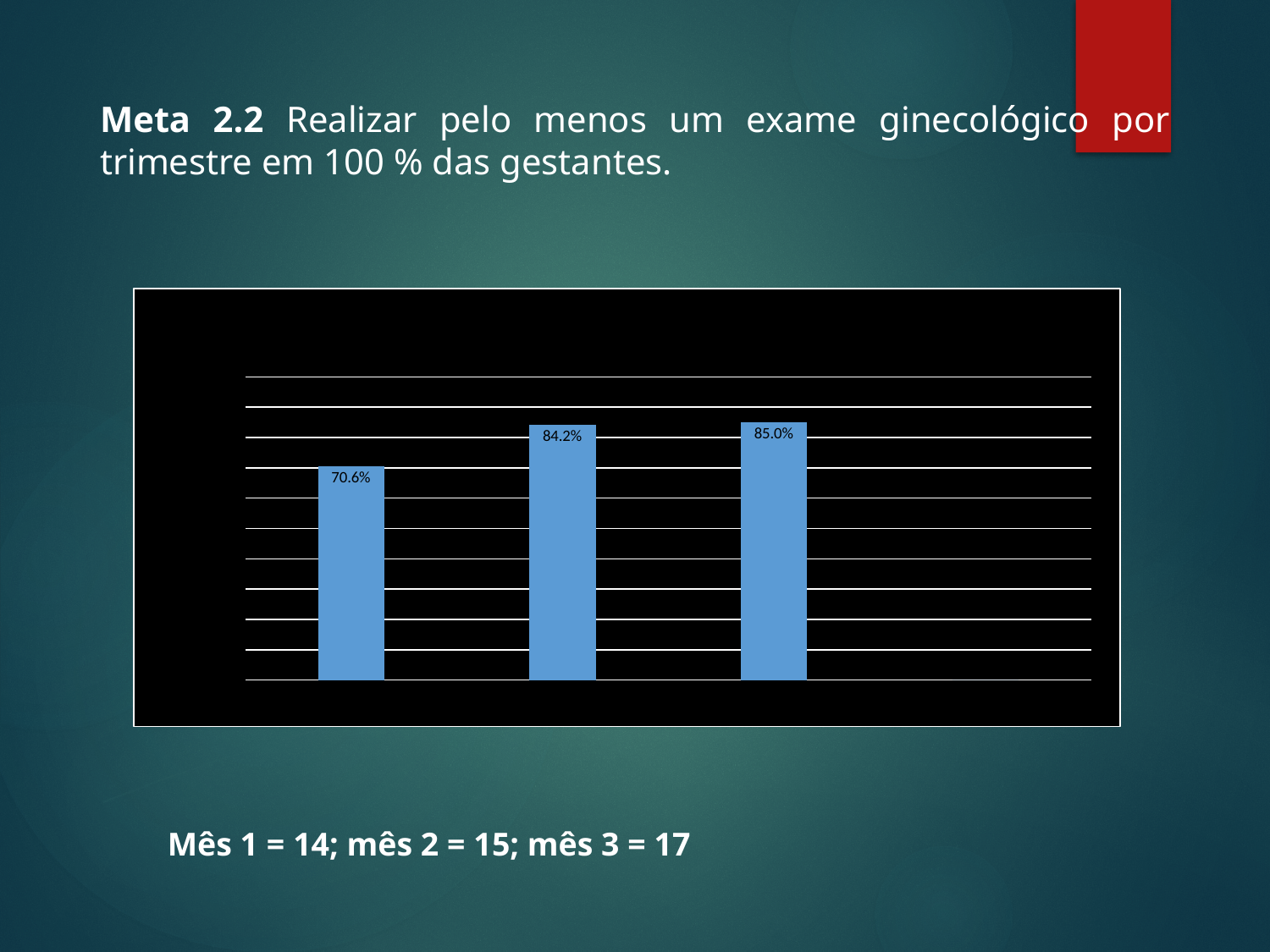
Which bar has the highest value in the chart? the rightmost (third) bar How many bars are plotted in the chart? 3 Which bar has the lowest value in the chart? the leftmost (first) bar What colour are the bars in the chart? blue Do the bar values rise or fall from left to right across the chart? rise What is the value shown on the rightmost bar of the chart? 85.0% What is the difference between the rightmost bar's value and the leftmost bar's value? 14.4 percentage points What is the difference between the middle bar's value and the leftmost bar's value? 13.6 percentage points What kind of chart is shown on the slide? bar chart Which is larger, the value of the leftmost bar or the value of the middle bar? the middle bar What is the value shown on the leftmost bar of the chart? 70.6% What is the value shown on the middle bar of the chart? 84.2%